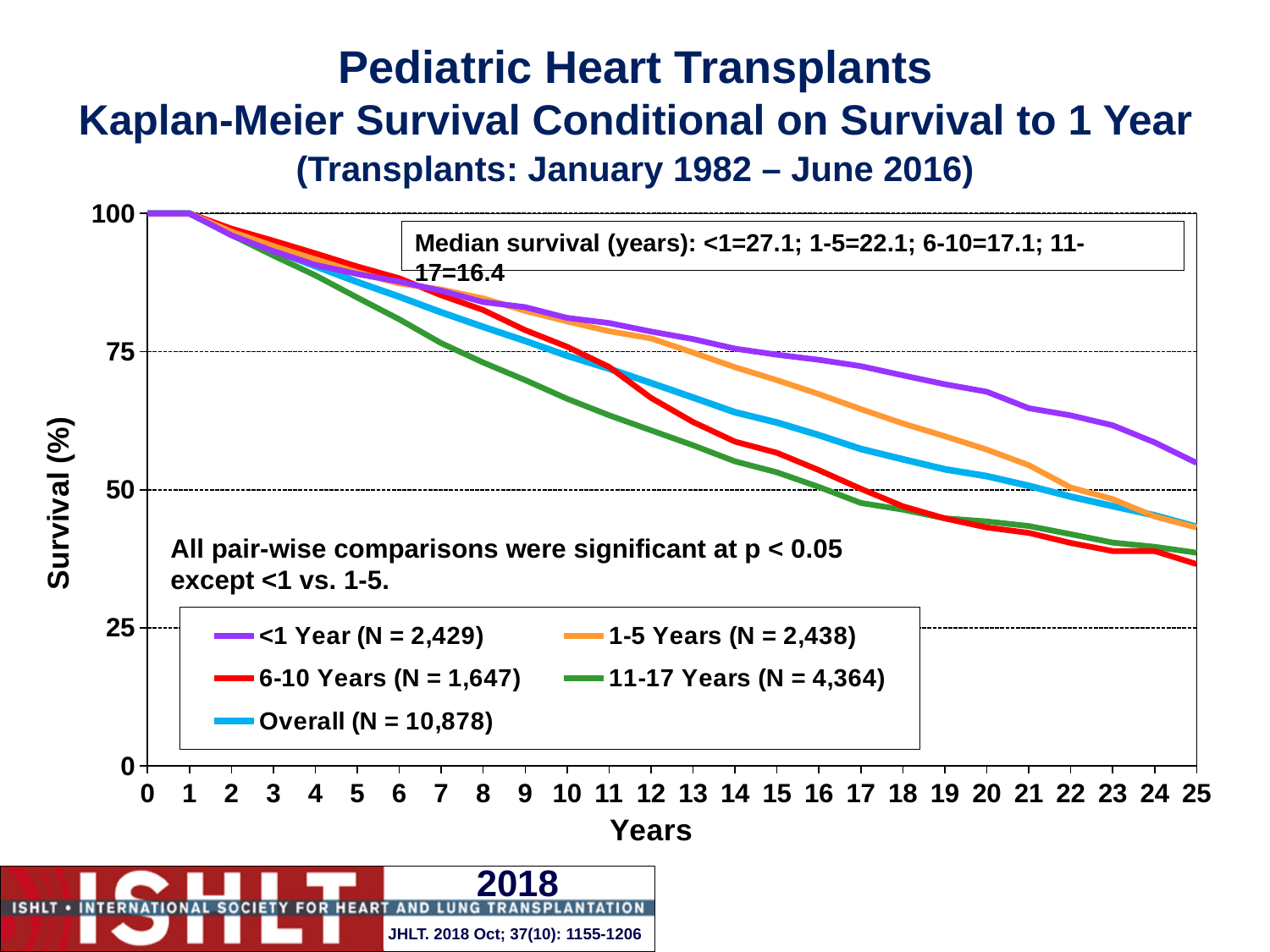
What is the median survival in years for the <1 Year group? 27.1 Do the survival curves rise or fall as years increase? fall At 10 years, which curve is higher: <1 Year or 11-17 Years? <1 Year What is the median survival in years for the 11-17 Years group? 16.4 What is the N for the Overall group shown in the legend? 10,878 What is the difference in median survival (years) between the <1 Year group and the 11-17 Years group? 10.7 Which age group has the highest median survival? <1 Year Is the survival value for the 6-10 Years group at 25 years greater or less than 50? less Which age group has the lowest median survival? 11-17 Years Is the survival value for the <1 Year group at 25 years greater or less than 50? greater What kind of chart is shown on the slide? line chart How many series does the legend list? 5